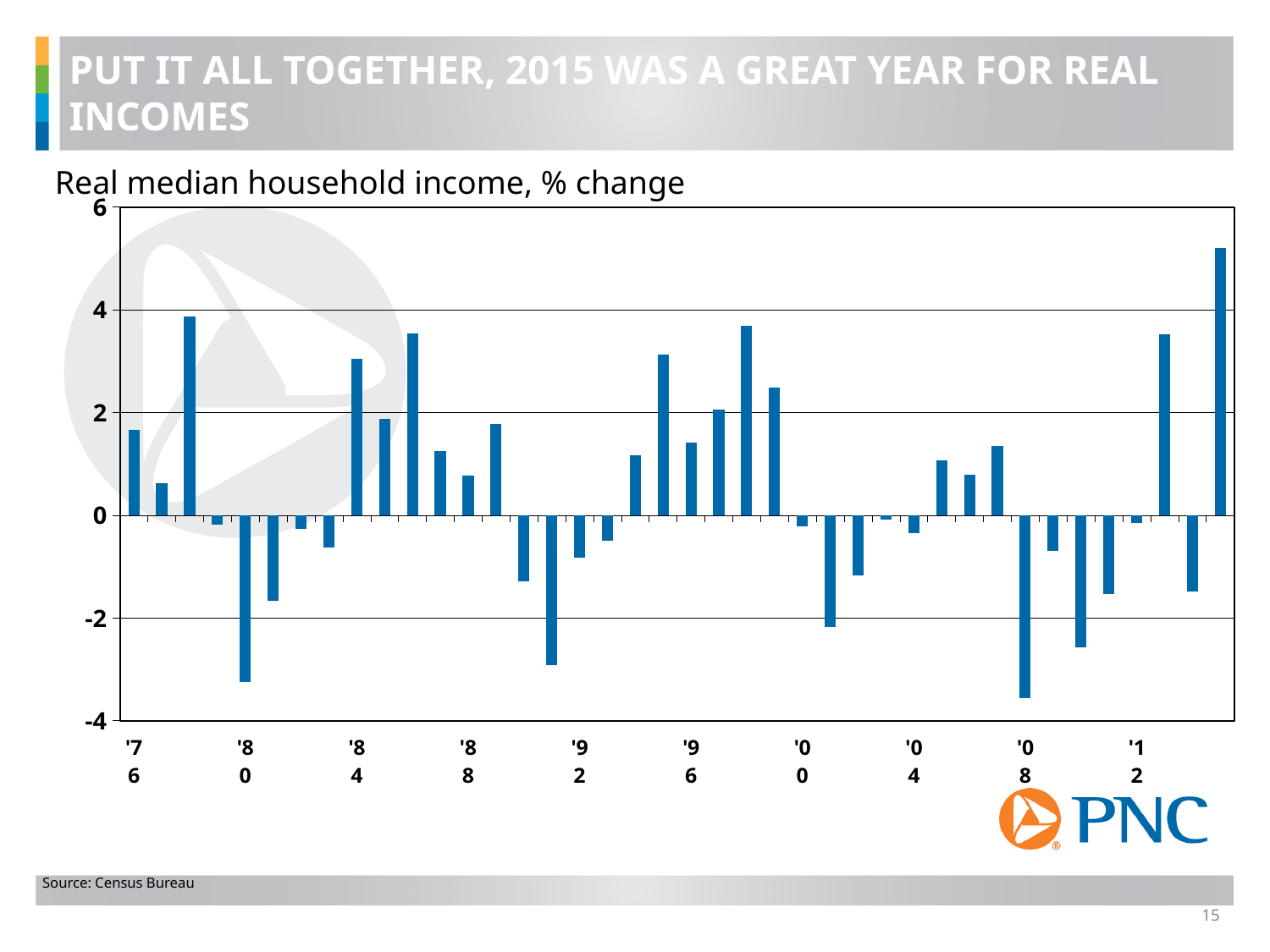
What source is cited for the chart? Census Bureau Is the value for '88 greater or less than 2? less Which bar has the highest value in the chart? the last bar on the right Is the value for '08 greater or less than -2? less What is the title of the chart? Real median household income, % change Which has the larger value, '84 or '80? '84 What kind of chart is shown on the slide? bar chart Is the value for '96 greater or less than 2? less